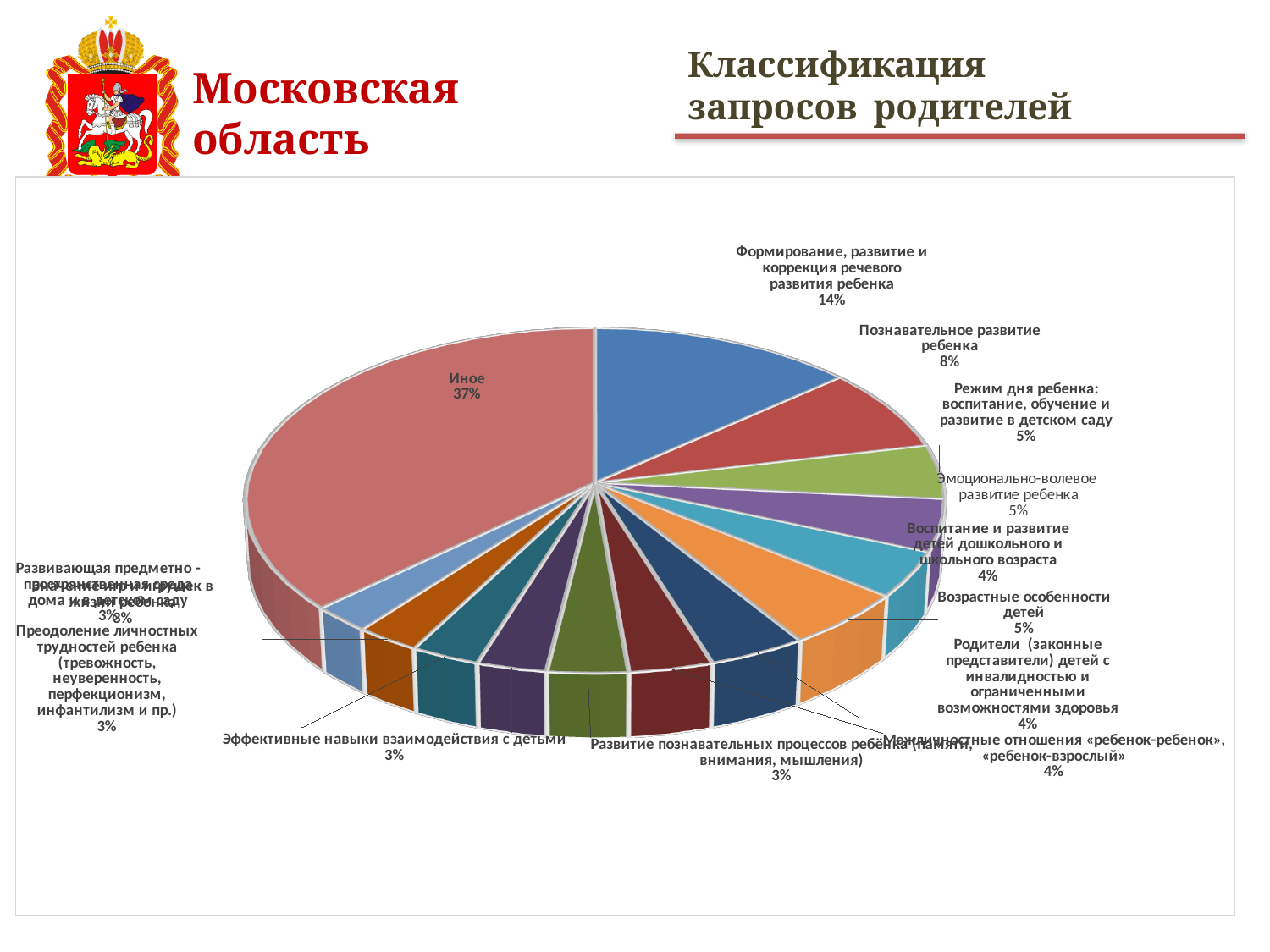
Which category has the largest share of the pie? Иное What percentage is shown for "Эффективные навыки взаимодействия с детьми"? 3% What is the title of the chart on the slide? Классификация запросов родителей What share of parents' requests falls under "Иное"? 37% What percentage is shown for "Познавательное развитие ребенка"? 8% Which is larger: the share for "Познавательное развитие ребенка" or for "Возрастные особенности детей"? Познавательное развитие ребенка What percentage is shown for "Формирование, развитие и коррекция речевого развития ребенка"? 14% What percentage is shown for "Режим дня ребенка: воспитание, обучение и развитие в детском саду"? 5% What percentage is shown for "Воспитание и развитие детей дошкольного и школьного возраста"? 4% What is the difference in percentage points between "Познавательное развитие ребенка" and "Межличностные отношения «ребенок-ребенок», «ребенок-взрослый»"? 4 What is the difference in percentage points between "Иное" and "Формирование, развитие и коррекция речевого развития ребенка"? 23 What kind of chart is shown on the slide? pie chart